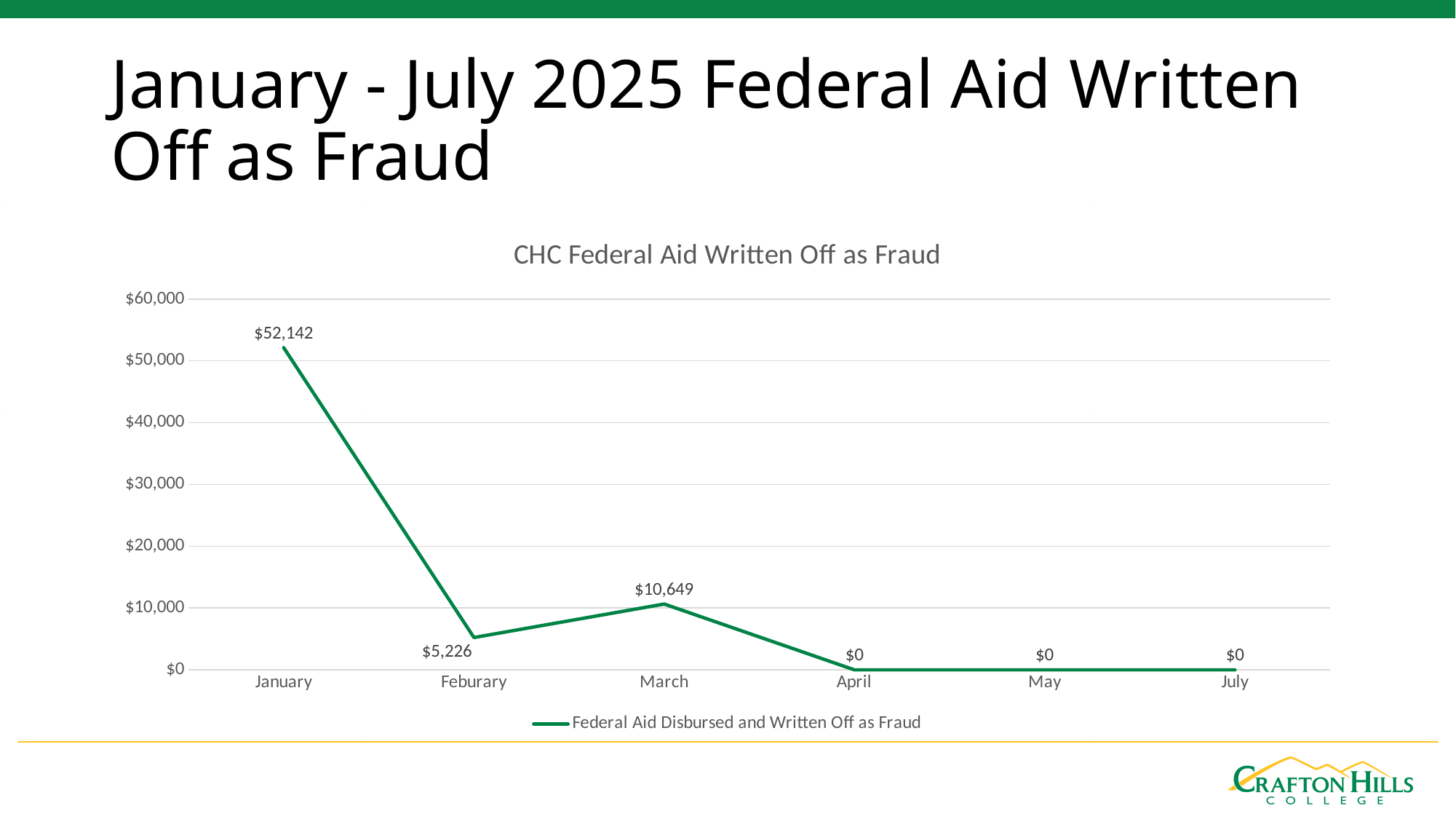
What is the value for Feburary? $5,226 What is the difference between the January and March values? $41,493 What is the value for January? $52,142 Which month has the highest value? January Is the value for January greater or less than $50,000? greater What is the difference between the March and Feburary values? $5,423 How many months are plotted on the x axis? 6 What kind of chart is shown? line chart What is the value for May? $0 What is the title of the chart? CHC Federal Aid Written Off as Fraud Which is larger, the value for Feburary or the value for March? March What is the value for March? $10,649